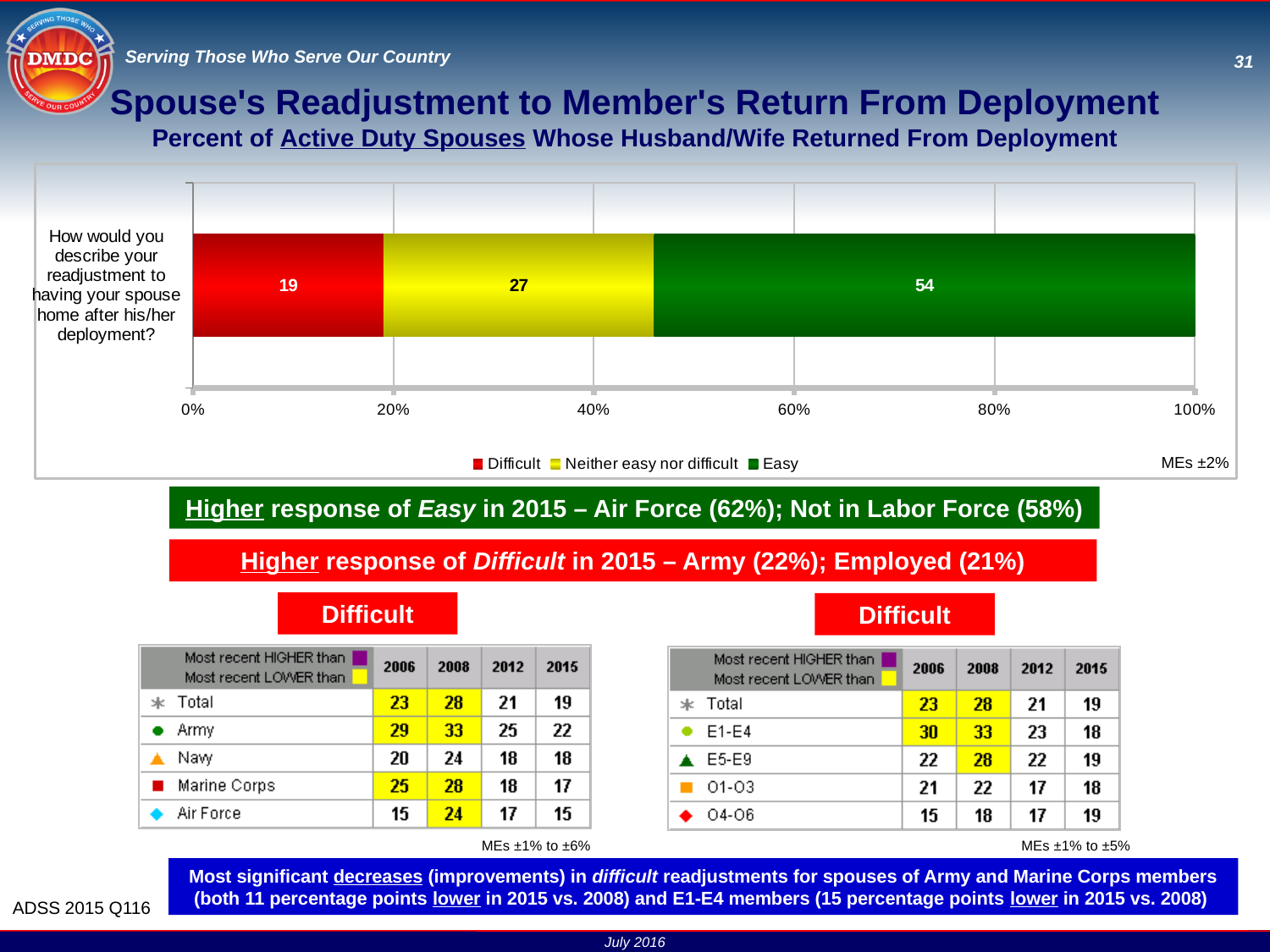
What is the total of the three segments in the stacked bar? 100 What is the margin of error noted for the chart? MEs ±2% Which response category has the largest share of the bar? Easy What percentage of active duty spouses described their readjustment as Neither easy nor difficult? 27 Which is larger, the Neither easy nor difficult response or the Difficult response? Neither easy nor difficult What percentage of active duty spouses described their readjustment as Easy? 54 What type of chart is shown on the slide? Stacked bar chart What is the difference in percentage points between the Easy and Difficult responses? 35 How many series does the chart legend list? 3 What colour represents the Easy response in the chart? Green Which response category has the smallest share of the bar? Difficult What percentage of active duty spouses described their readjustment as Difficult? 19